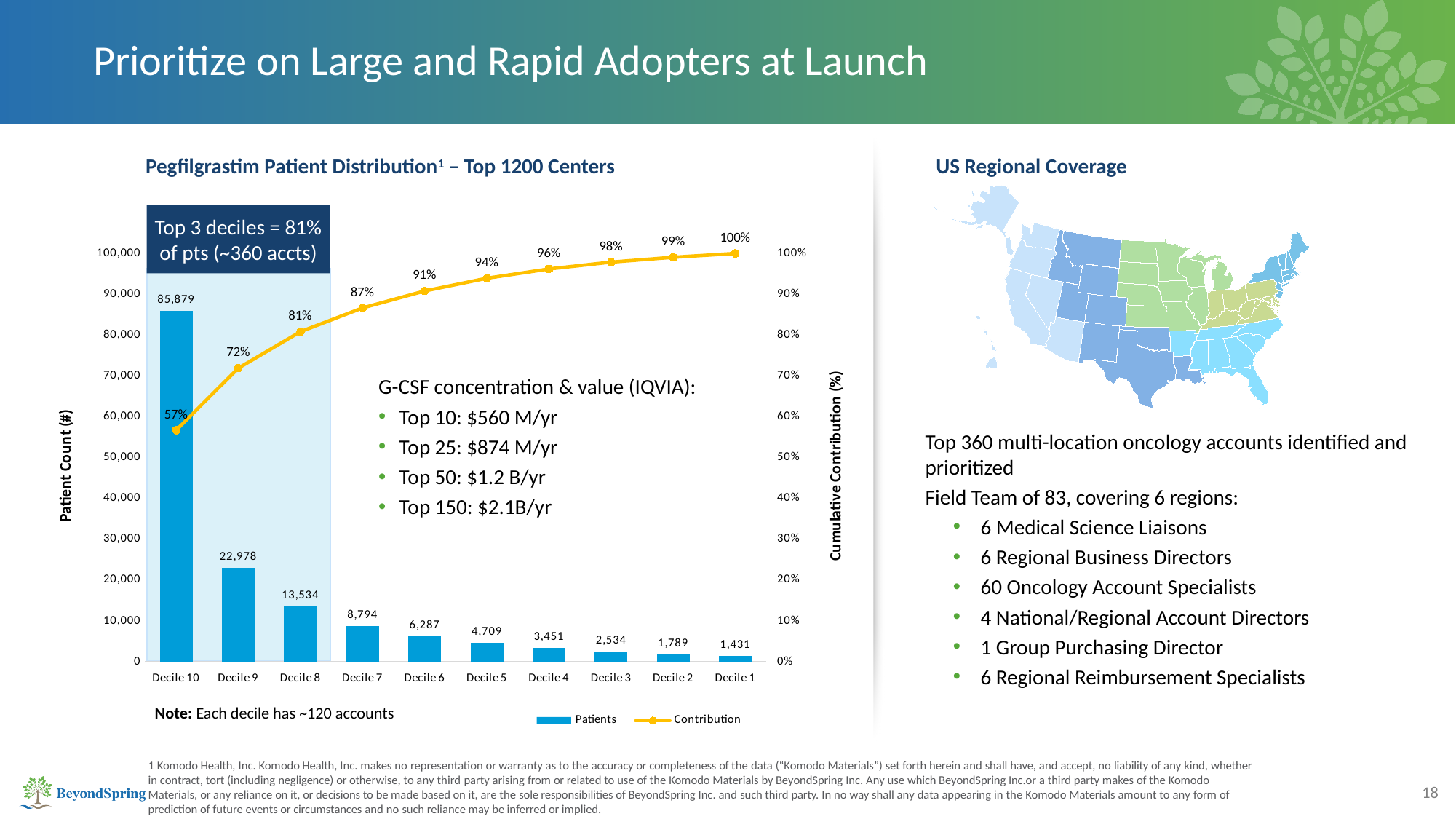
What is the label of the left vertical axis? Patient Count (#) What are the two series named in the legend? Patients and Contribution Which has a larger patient count, Decile 7 or Decile 6? Decile 7 Does the cumulative contribution line rise or fall from Decile 10 to Decile 1? rise How many series does the legend list? 2 What is the difference in patient count between Decile 9 and Decile 8? 9,444 What is the patient count for Decile 10? 85,879 What is the patient count for Decile 5? 4,709 How many deciles are shown on the x axis? 10 Which decile has the highest patient count? Decile 10 What is the cumulative contribution at Decile 8? 81% Which decile has the lowest patient count? Decile 1